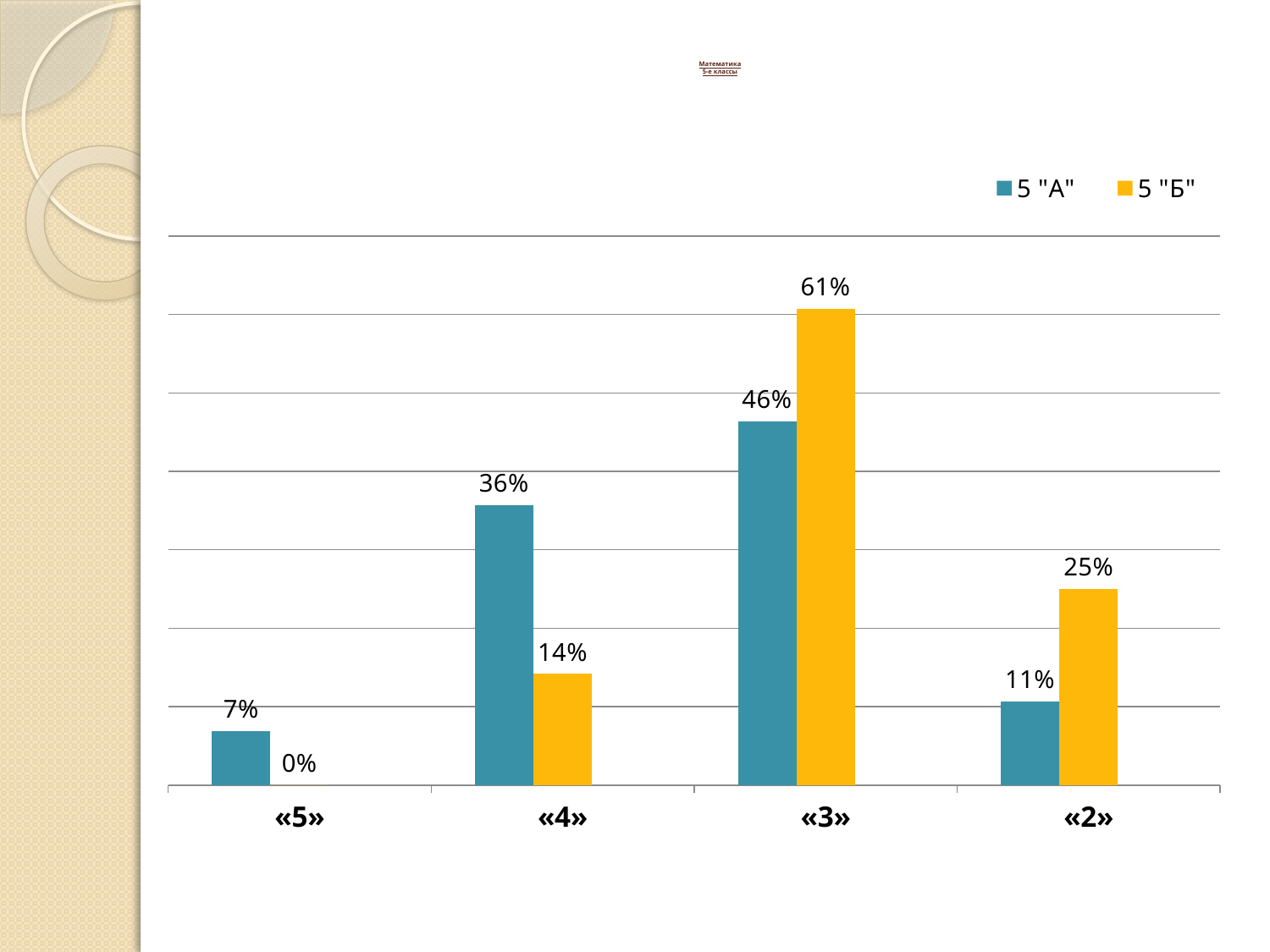
What is the value for 5 "Б" in the «5» category? 0% How many categories are shown on the x axis? 4 Which series has the larger value in the «4» category, 5 "А" or 5 "Б"? 5 "А" What kind of chart is shown on the slide? Bar chart Which category has the lowest value for 5 "А"? «5» Which series has the larger value in the «2» category, 5 "А" or 5 "Б"? 5 "Б" Which category has the highest value for 5 "Б"? «3» What is the value for 5 "Б" in the «4» category? 14% What is the value for 5 "А" in the «3» category? 46% What is the difference between 5 "Б" and 5 "А" in the «3» category? 15% How many series does the legend list? 2 What is the value for 5 "А" in the «2» category? 11%